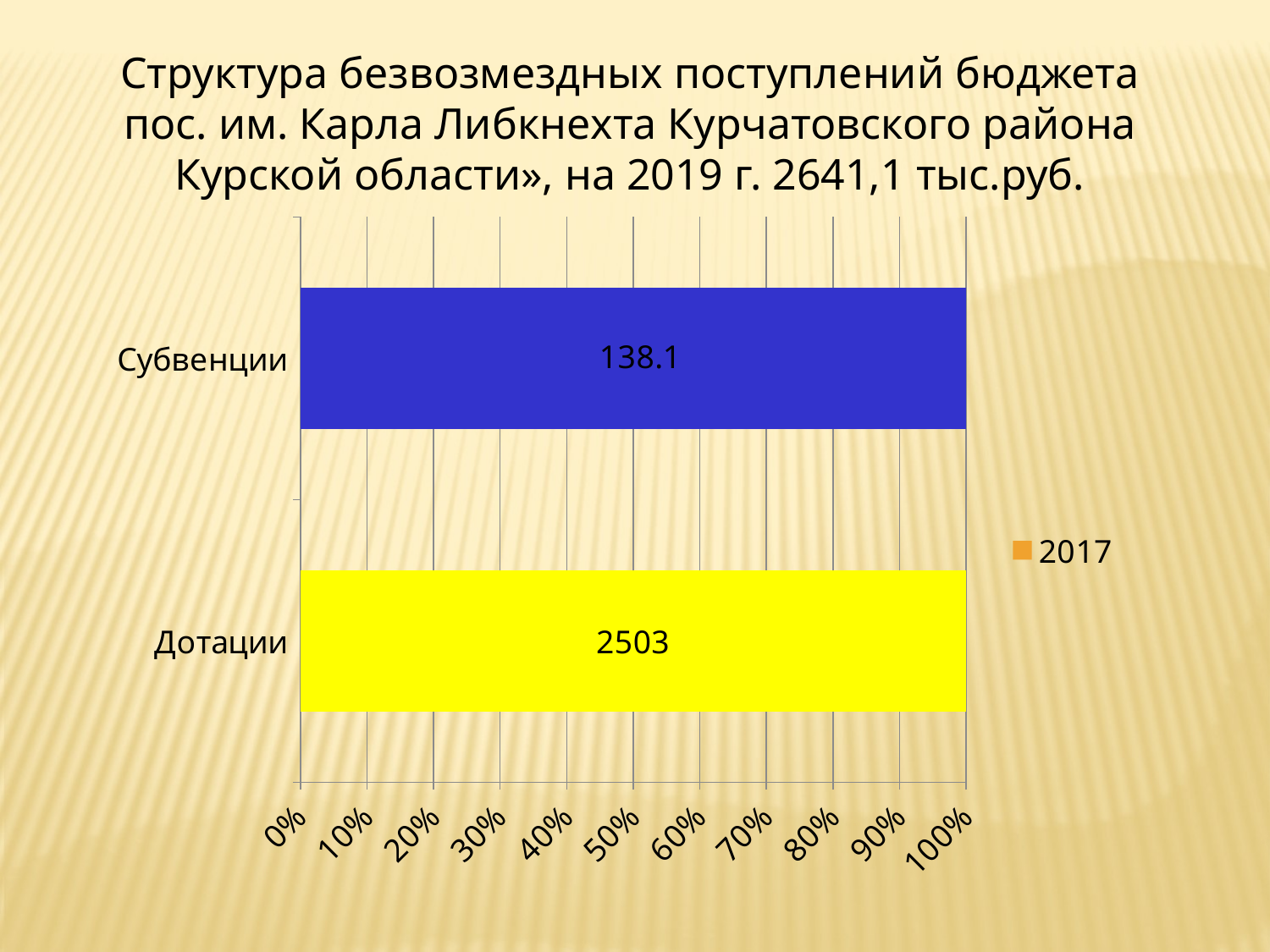
Which category has the lowest labelled value? Субвенции How many categories are shown on the chart? 2 What is the data label on the bar for Дотации? 2503 Which category has the larger labelled value, Субвенции or Дотации? Дотации What entry is shown in the chart legend? 2017 What colour is the bar for Дотации? Yellow What is the data label on the bar for Субвенции? 138.1 Which category has the highest labelled value? Дотации What kind of chart is shown on the slide? Bar chart What is the difference between the labelled values for Дотации and Субвенции? 2364.9 How many series does the legend list? 1